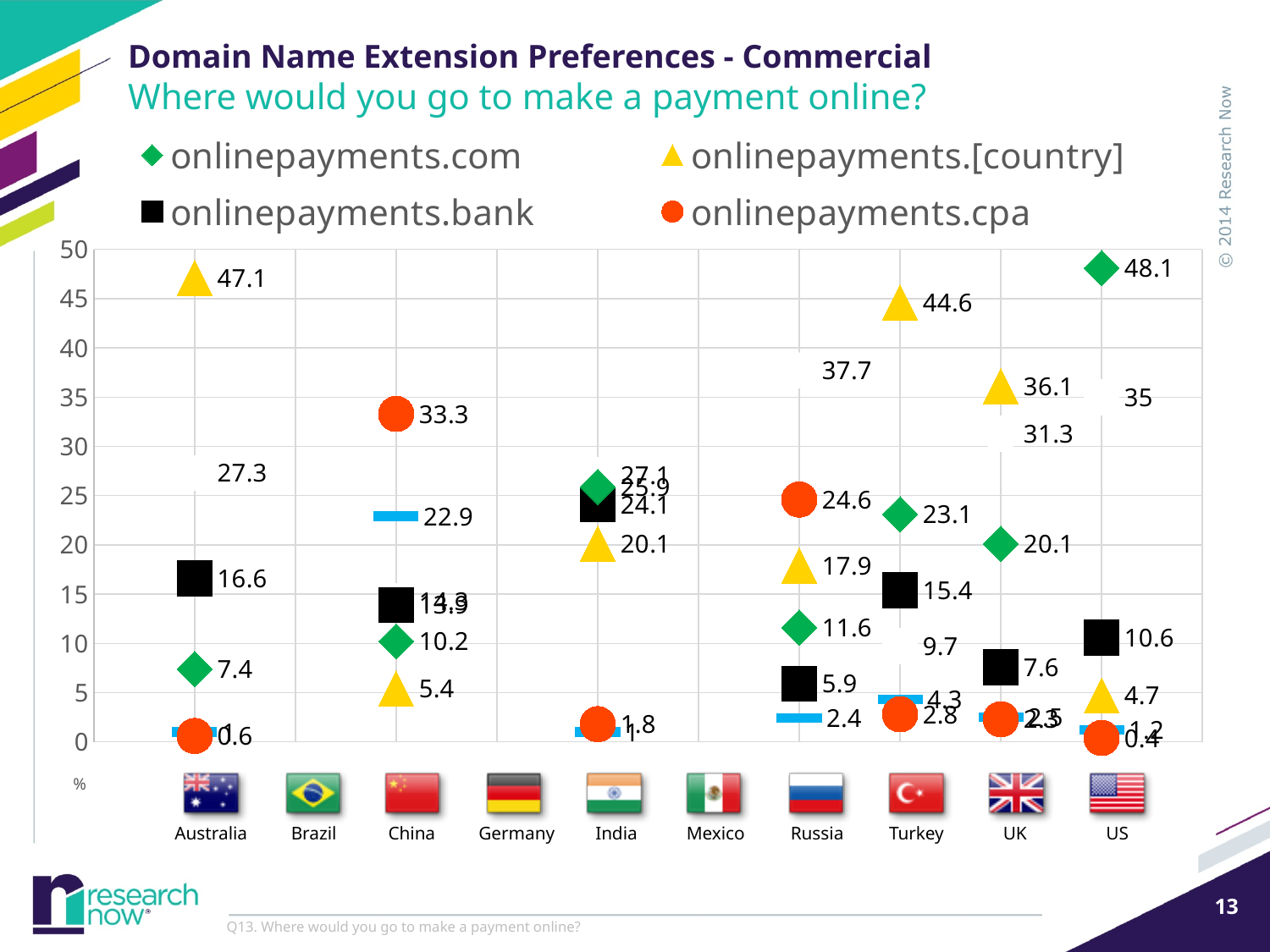
What is the value for onlinepayments.com in the US? 48.1 Which country has the highest value for onlinepayments.com? US How many series does the legend list? 4 What is the difference between onlinepayments.[country] and onlinepayments.bank in Australia? 30.5 What is the value for onlinepayments.[country] in Turkey? 44.6 How many countries are shown on the x axis? 10 Which country has the highest value for onlinepayments.cpa? China Is the value for onlinepayments.[country] in the UK greater or less than 35? greater What is the value for onlinepayments.cpa in China? 33.3 What is the value for onlinepayments.bank in the US? 10.6 In Russia, which is larger: onlinepayments.cpa or onlinepayments.[country]? onlinepayments.cpa What is the value for onlinepayments.[country] in Australia? 47.1